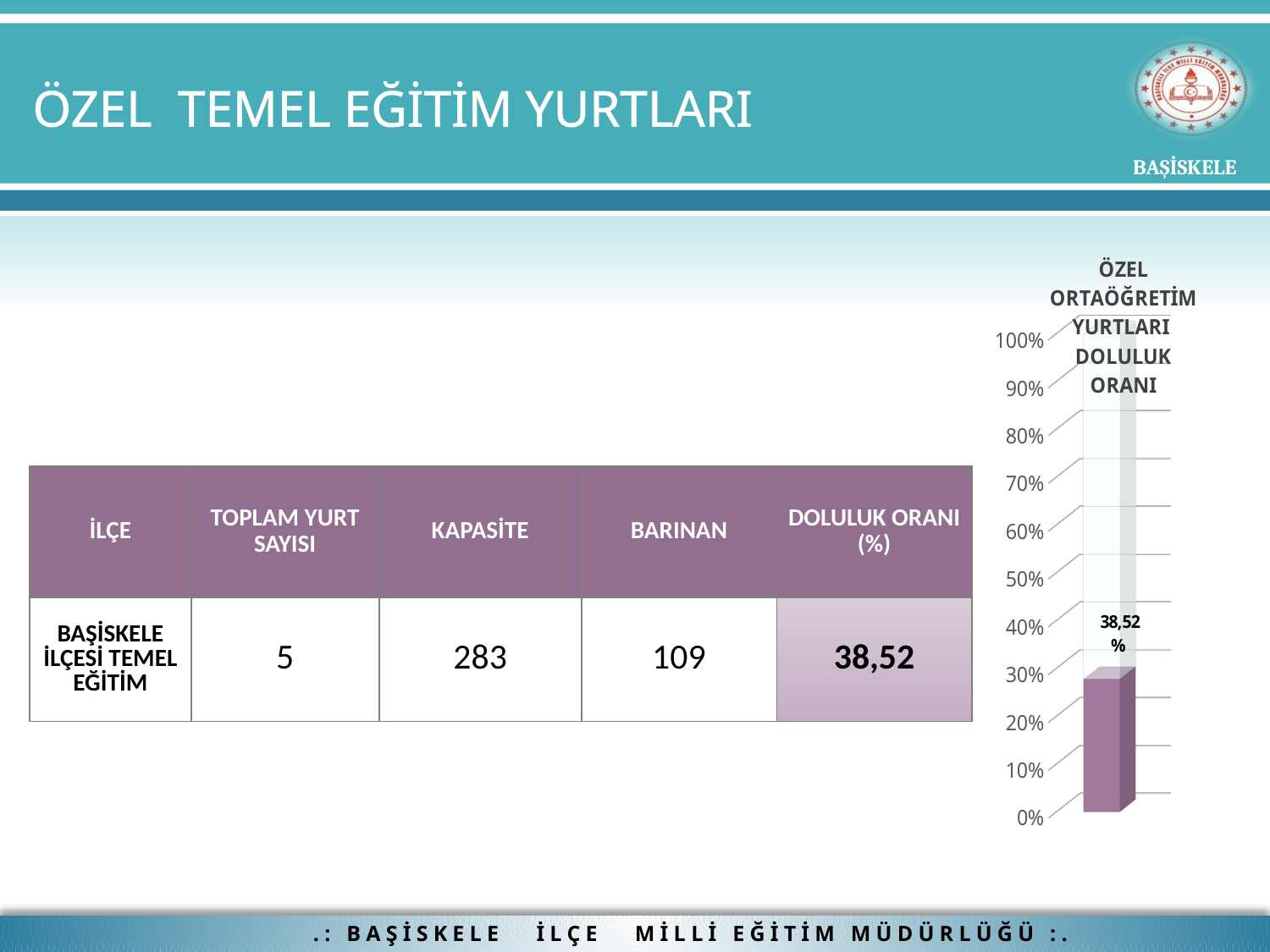
How many bars are plotted in the chart? 1 What is the title of the chart? ÖZEL ORTAÖĞRETİM YURTLARI DOLULUK ORANI Is the value of the bar in the chart greater or less than 20%? greater What is the highest value shown on the chart's vertical axis? 100% What kind of chart is shown on the slide? bar chart Is the value of the bar in the chart greater or less than 50%? less What value is shown by the data label on the bar in the chart? 38,52 %